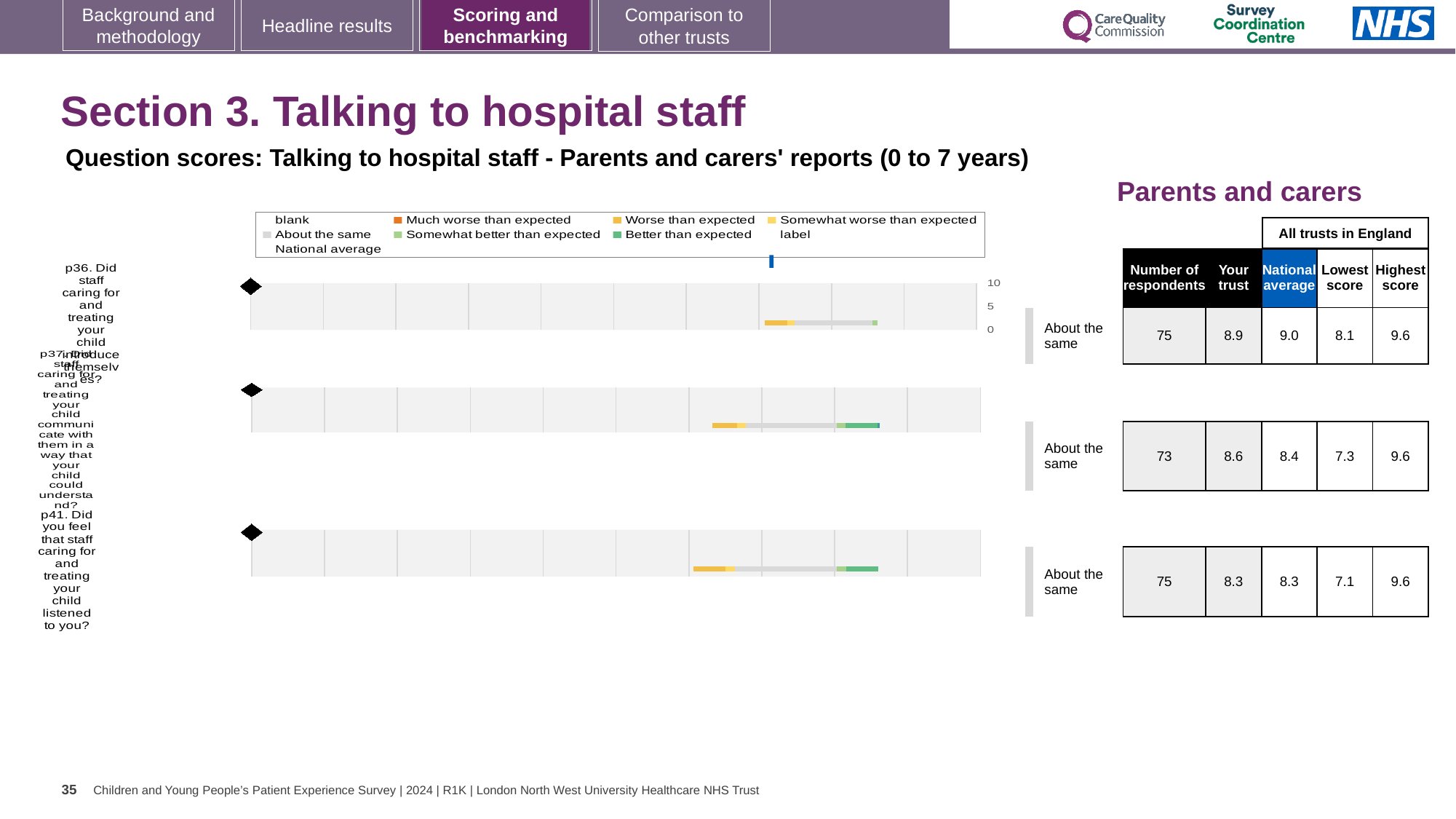
How many respondents answered p37? 73 Which of the three questions has the lowest 'Lowest score' among all trusts in England? p41 Which of the three questions has the highest 'Your trust' score? p36 What benchmark category is shown for p41? About the same What is the National average score for p37 (Did staff communicate in a way your child could understand?)? 8.4 What is the 'Your trust' score for p36 (Did staff introduce themselves?)? 8.9 What is the Lowest score across all trusts in England for p41 (Did staff listen to you?)? 7.1 What is the Highest score among all trusts in England for p37? 9.6 What is the difference between the Highest score and the Lowest score for p36? 1.5 How many survey questions (p36, p37, p41) are plotted on this slide? 3 For p37, which is larger: the 'Your trust' score or the National average? Your trust What kind of chart is used to show the question scores on this slide? bar chart